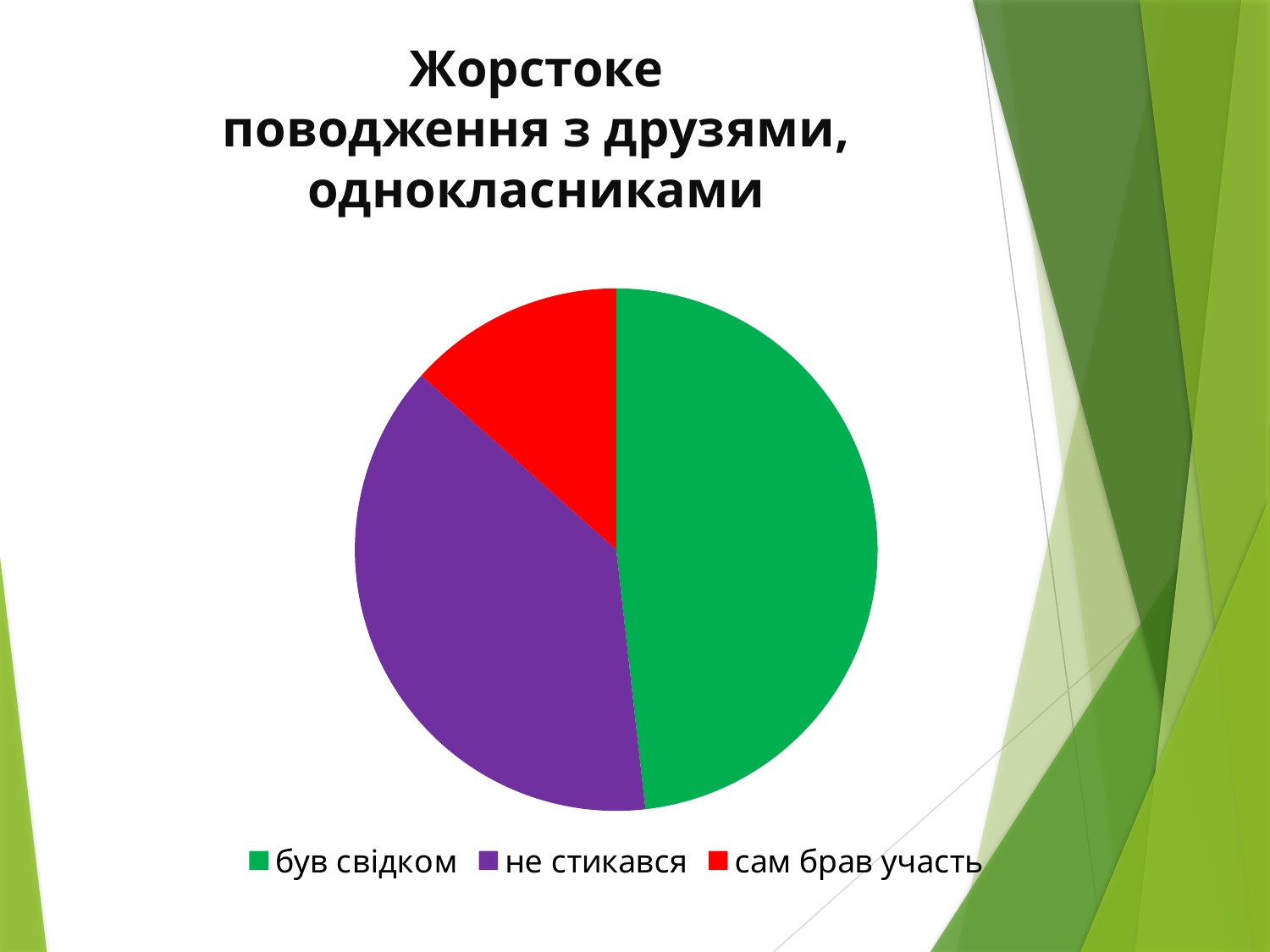
How many slices does the pie chart have? 3 Which slice is larger: "був свідком" or "не стикався"? був свідком Which colour represents "сам брав участь" in the pie chart? red What is the title of the chart? Жорстоке поводження з друзями, однокласниками Which category has the largest slice of the pie? був свідком Which category has the smallest slice of the pie? сам брав участь How many entries does the legend list? 3 Which slice is larger: "не стикався" or "сам брав участь"? не стикався What kind of chart is shown on the slide? pie chart